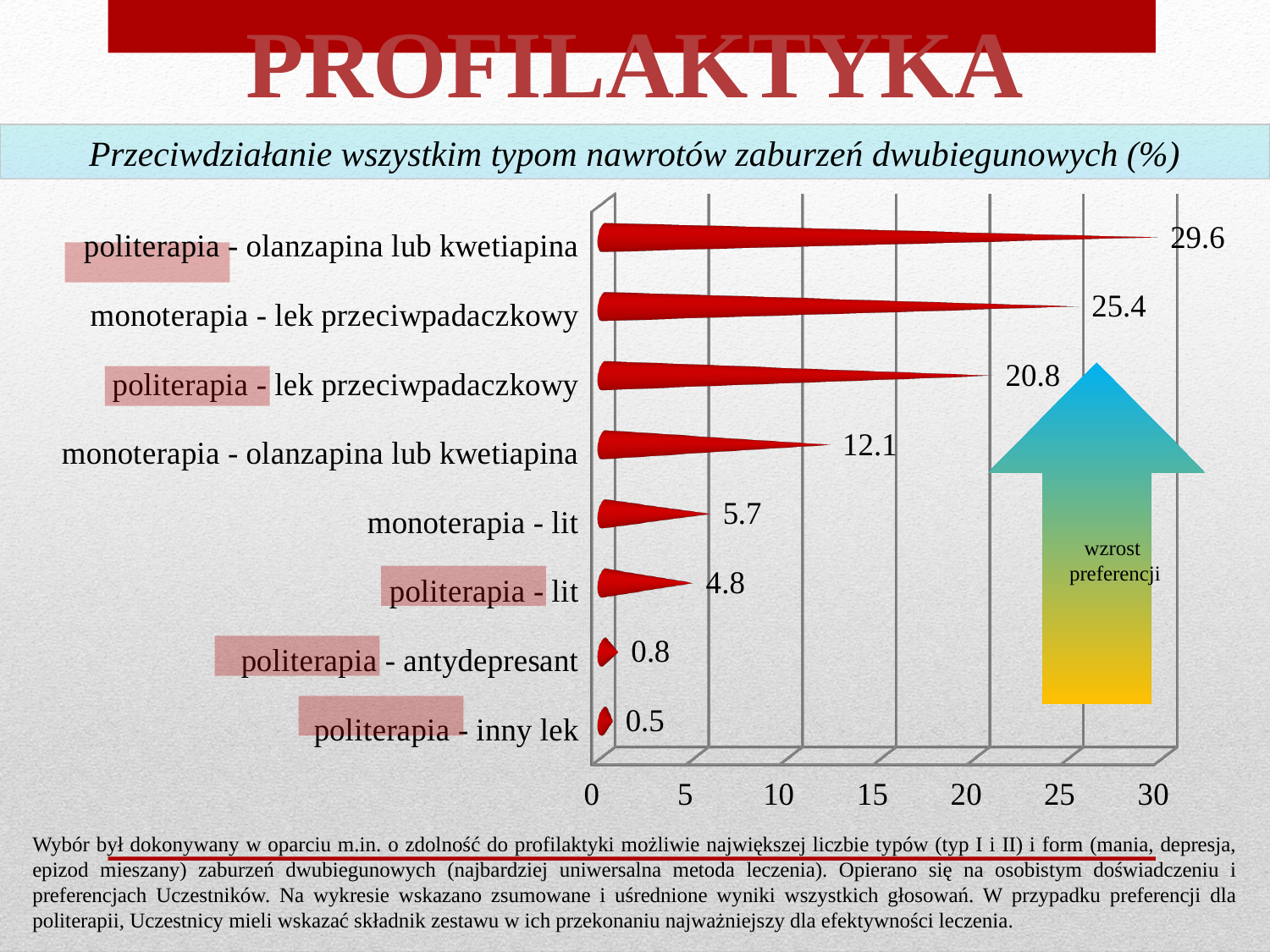
Is the value for "monoterapia - olanzapina lub kwetiapina" greater or less than 10? greater What is the value for "politerapia - antydepresant"? 0.8 How many categories are shown in the chart? 8 What is the value for "politerapia - olanzapina lub kwetiapina"? 29.6 What is the value for "monoterapia - lit"? 5.7 What is the difference between "monoterapia - lek przeciwpadaczkowy" and "politerapia - lek przeciwpadaczkowy"? 4.6 Which is larger, "monoterapia - lit" or "politerapia - lit"? monoterapia - lit What is the title of the chart? Przeciwdziałanie wszystkim typom nawrotów zaburzeń dwubiegunowych (%) Which category has the highest value? politerapia - olanzapina lub kwetiapina What is the difference between "politerapia - olanzapina lub kwetiapina" and "monoterapia - olanzapina lub kwetiapina"? 17.5 What kind of chart is shown on the slide? bar chart Which category has the lowest value? politerapia - inny lek